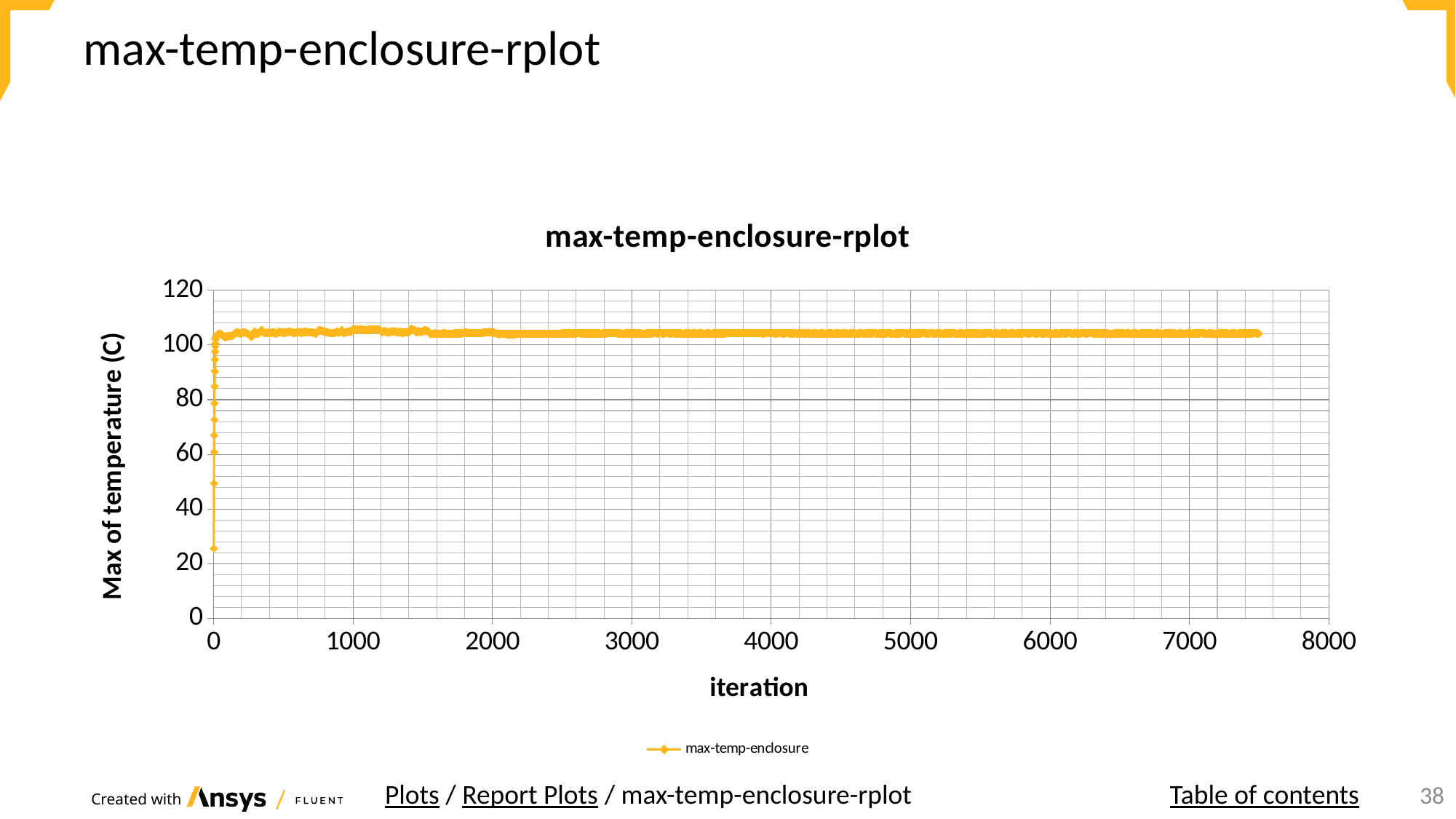
What is the name of the series shown in the legend? max-temp-enclosure What is the highest value shown on the x axis? 8000 What is the label of the x axis? iteration How many series does the legend list? 1 What is the title of the chart? max-temp-enclosure-rplot What kind of chart is shown on the slide? line chart Is the value for max-temp-enclosure at iteration 4000 greater or less than 80? greater What is the label of the y axis? Max of temperature (C) After about iteration 1000, does the value for max-temp-enclosure stay roughly flat, rise steadily, or fall steadily? stay roughly flat Is the value for max-temp-enclosure at iteration 0 greater or less than 40? less Does the value for max-temp-enclosure rise or fall between iteration 0 and iteration 1000? rise What is the highest value shown on the y axis? 120